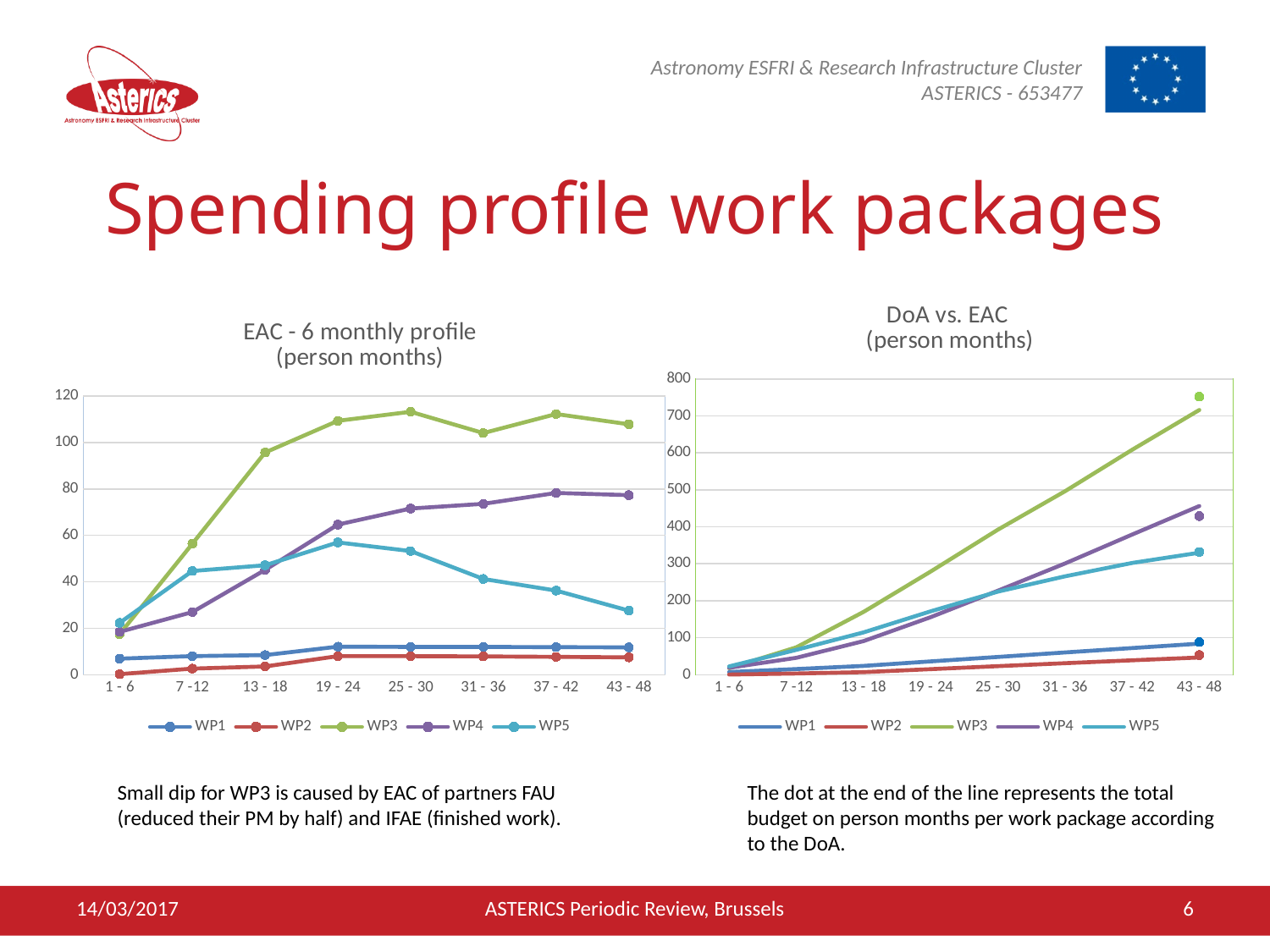
In the left chart (EAC - 6 monthly profile), how many periods are shown on the x axis? 8 In the left chart (EAC - 6 monthly profile), is the value for WP3 in the 25 - 30 period greater or less than 100? greater What kind of chart is the left chart titled "EAC - 6 monthly profile (person months)"? line chart In the left chart (EAC - 6 monthly profile), does the WP5 line rise or fall from the 19 - 24 period to the 43 - 48 period? fall What is the title of the right chart? DoA vs. EAC (person months) In the right chart (DoA vs. EAC), which work package has the highest value in the 43 - 48 period? WP3 In the left chart (EAC - 6 monthly profile), how many series does the legend list? 5 In the left chart (EAC - 6 monthly profile), which work package has the highest value in the 43 - 48 period? WP3 In the right chart (DoA vs. EAC), is the value of the WP3 line in the 43 - 48 period greater or less than 600? greater In the left chart (EAC - 6 monthly profile), which work package has the lowest value in the 1 - 6 period? WP2 In the right chart (DoA vs. EAC), which is larger in the 43 - 48 period, the WP4 line or the WP5 line? WP4 In the left chart (EAC - 6 monthly profile), is the value for WP5 in the 43 - 48 period greater or less than 40? less